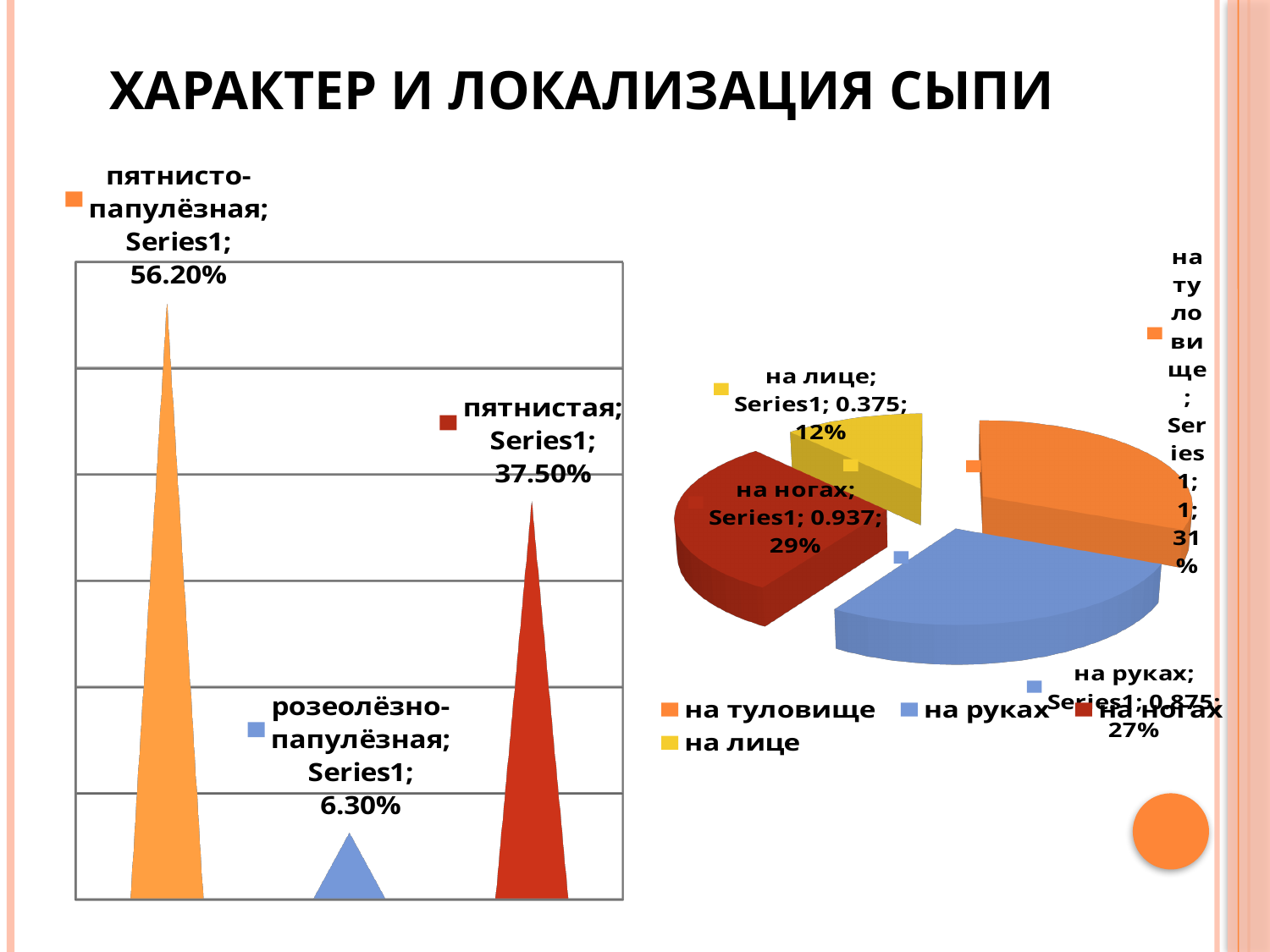
In the pie chart on the right, what percentage is shown for на лице? 12% What kind of chart is the chart on the right? pie chart In the left chart, what is the value for розеолёзно-папулёзная? 6.30% In the pie chart on the right, which slice is the smallest? на лице In the left chart, what is the value for пятнистая? 37.50% In the left chart, what is the difference between the values for пятнисто-папулёзная and пятнистая? 18.70% How many entries does the legend of the pie chart on the right list? 4 In the left chart, which category has the highest value? пятнисто-папулёзная In the pie chart on the right, which is larger: на ногах or на руках? на ногах In the pie chart on the right, what percentage is shown for на туловище? 31% How many categories are shown in the left chart? 3 In the left chart, what is the value for пятнисто-папулёзная? 56.20%